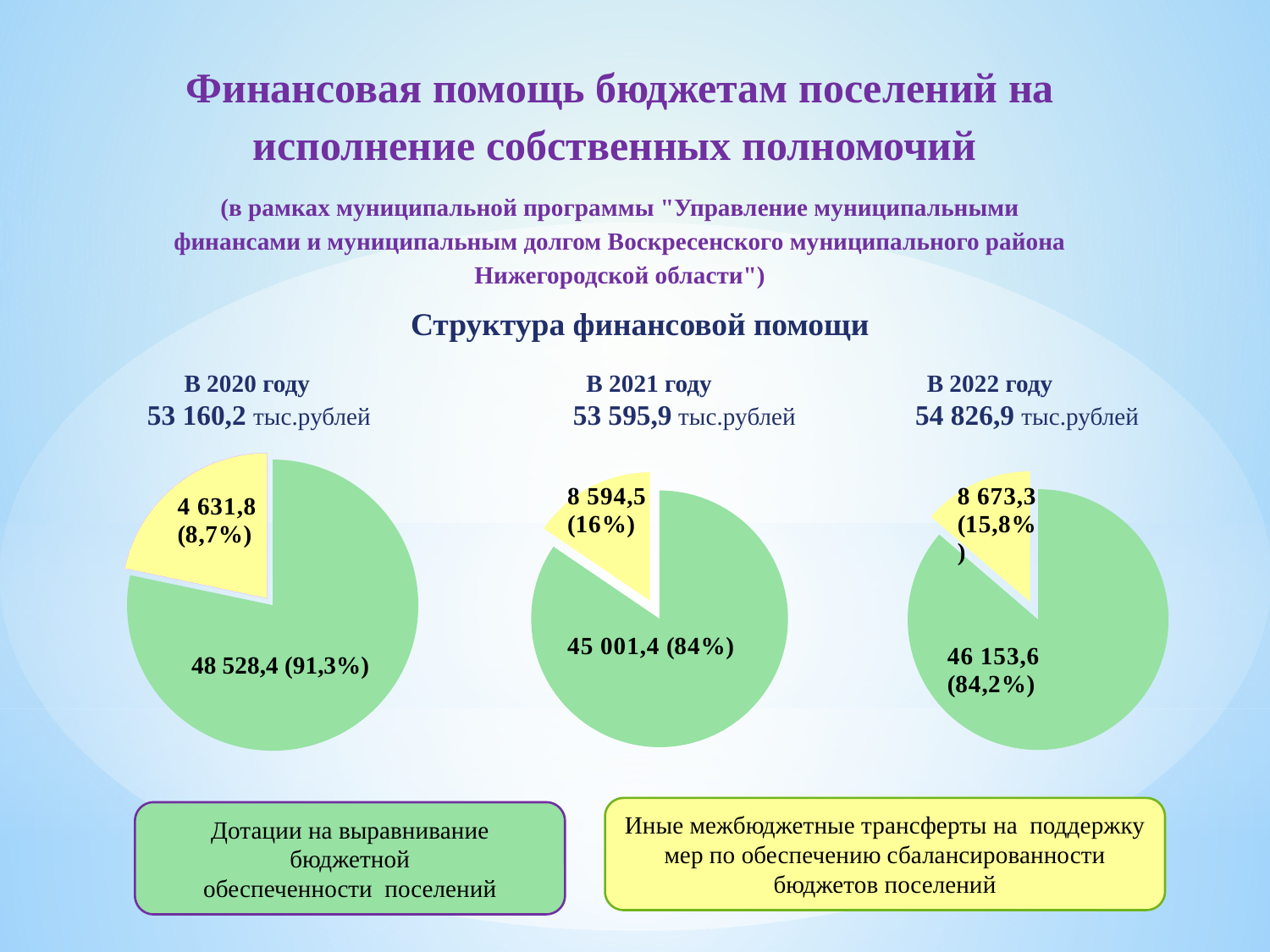
На диаграмме «В 2020 году» какую долю составляют иные межбюджетные трансферты? 8,7% Какого типа диаграммы показаны на слайде? Круговые диаграммы Каким цветом на диаграммах обозначены иные межбюджетные трансферты? Жёлтым На диаграмме «В 2020 году» какая категория имеет наибольшее значение? Дотации на выравнивание бюджетной обеспеченности поселений На диаграмме «В 2022 году» какое значение у дотаций на выравнивание бюджетной обеспеченности поселений? 46 153,6 На диаграмме «В 2021 году» какую долю составляют дотации на выравнивание бюджетной обеспеченности поселений? 84% Что больше: иные межбюджетные трансферты в 2021 году или в 2022 году? В 2022 году На диаграмме «В 2021 году» какое значение у иных межбюджетных трансфертов? 8 594,5 Сколько круговых диаграмм на слайде? 3 На диаграмме «В 2020 году» какое значение у дотаций на выравнивание бюджетной обеспеченности поселений? 48 528,4 На диаграмме «В 2022 году» какую долю составляют иные межбюджетные трансферты? 15,8% Какой общий объём финансовой помощи указан для 2022 года? 54 826,9 тыс.рублей